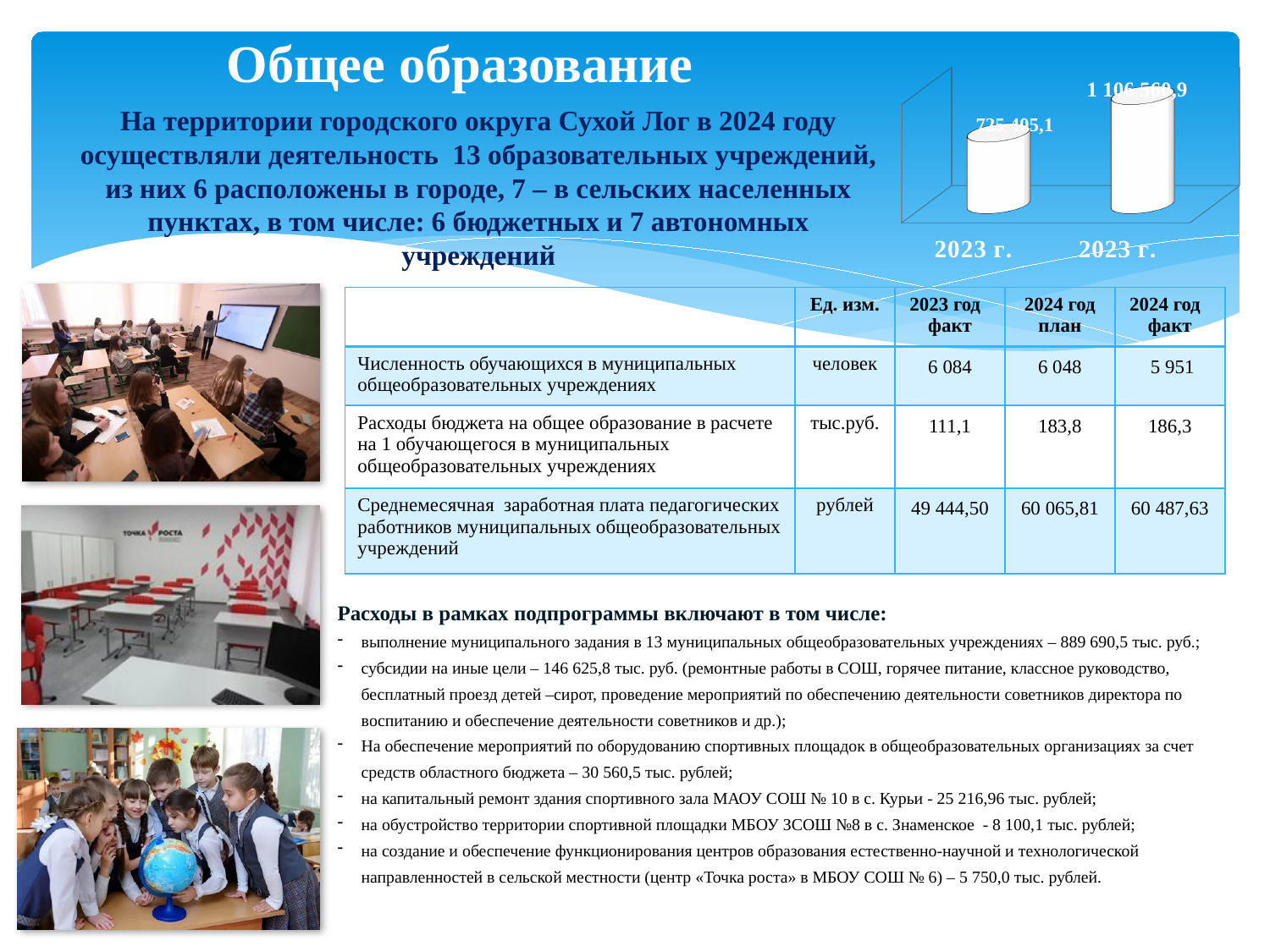
What label is printed under the left bar of the chart in the top right corner of the slide? 2023 г. In the chart in the top right corner of the slide, which bar has the highest value? the right (second) bar Do the values in the chart in the top right corner of the slide rise or fall from left to right? rise Are the bars in the chart in the top right corner of the slide vertical or horizontal? vertical What kind of chart is shown in the top right corner of the slide? bar chart How many bars does the chart in the top right corner of the slide have? 2 In the chart in the top right corner of the slide, which bar has the lowest value? the left (first) bar In the chart in the top right corner of the slide, which bar is taller, the left one or the right one? the right one